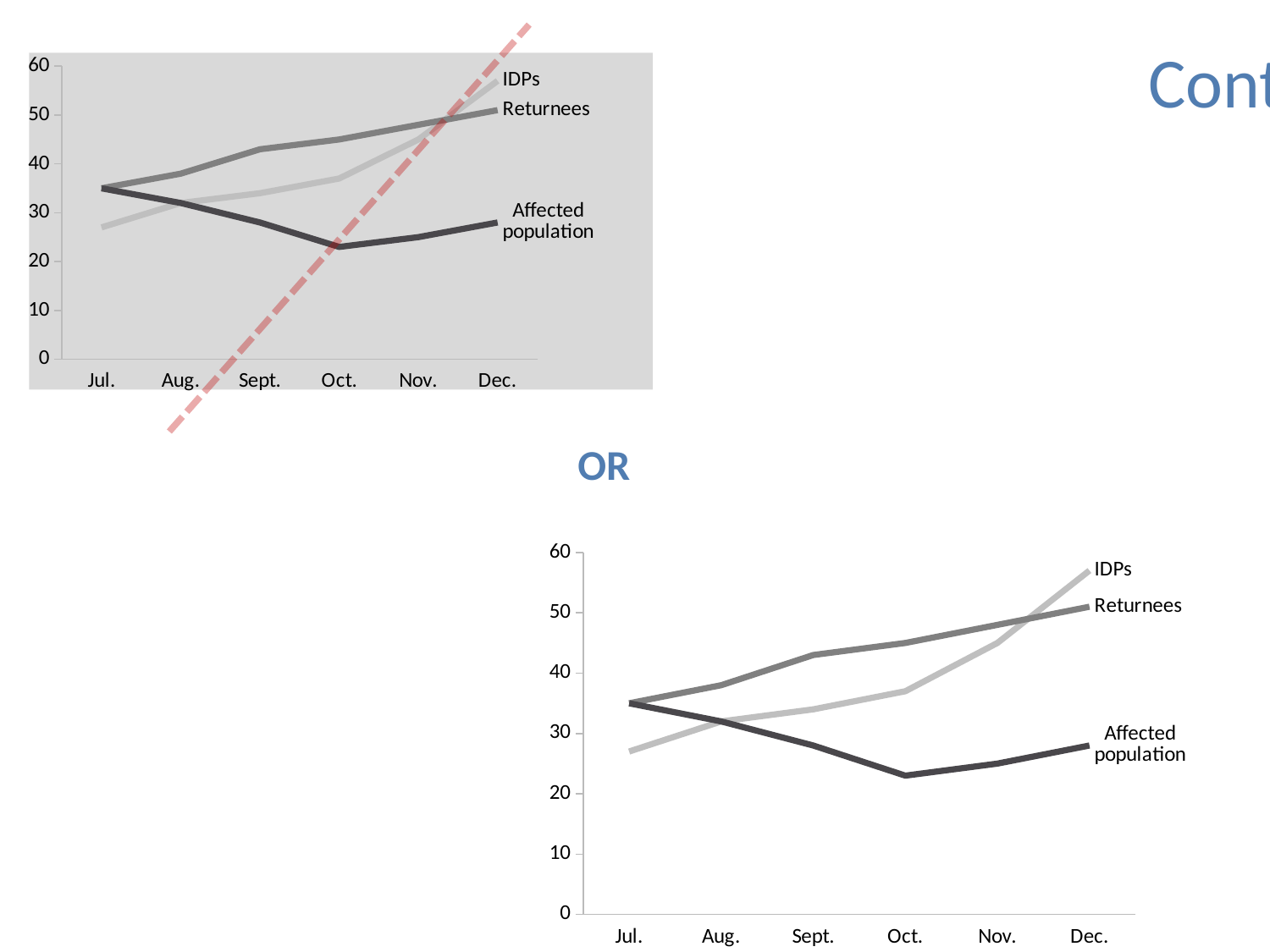
In the top-left chart, which is larger in Sept., Returnees or Affected population? Returnees In the bottom-right chart, does the IDPs line rise or fall from Jul. to Dec.? rise In the bottom-right chart, which series has the highest value in Dec.? IDPs In the bottom-right chart, does the Affected population line rise or fall from Jul. to Oct.? fall In the bottom-right chart, is the value for Affected population in Oct. greater or less than 30? less In the bottom-right chart, how many series are plotted? 3 In the bottom-right chart, how many months are shown on the x axis? 6 What kind of chart is the bottom-right chart? line chart In the bottom-right chart, which series has the lowest value in Dec.? Affected population In the bottom-right chart, is the value for Returnees in Jul. greater or less than 40? less In the bottom-right chart, is the value for IDPs in Dec. greater or less than 50? greater What is drawn across the top-left chart that is not on the bottom-right chart? a red dashed diagonal line